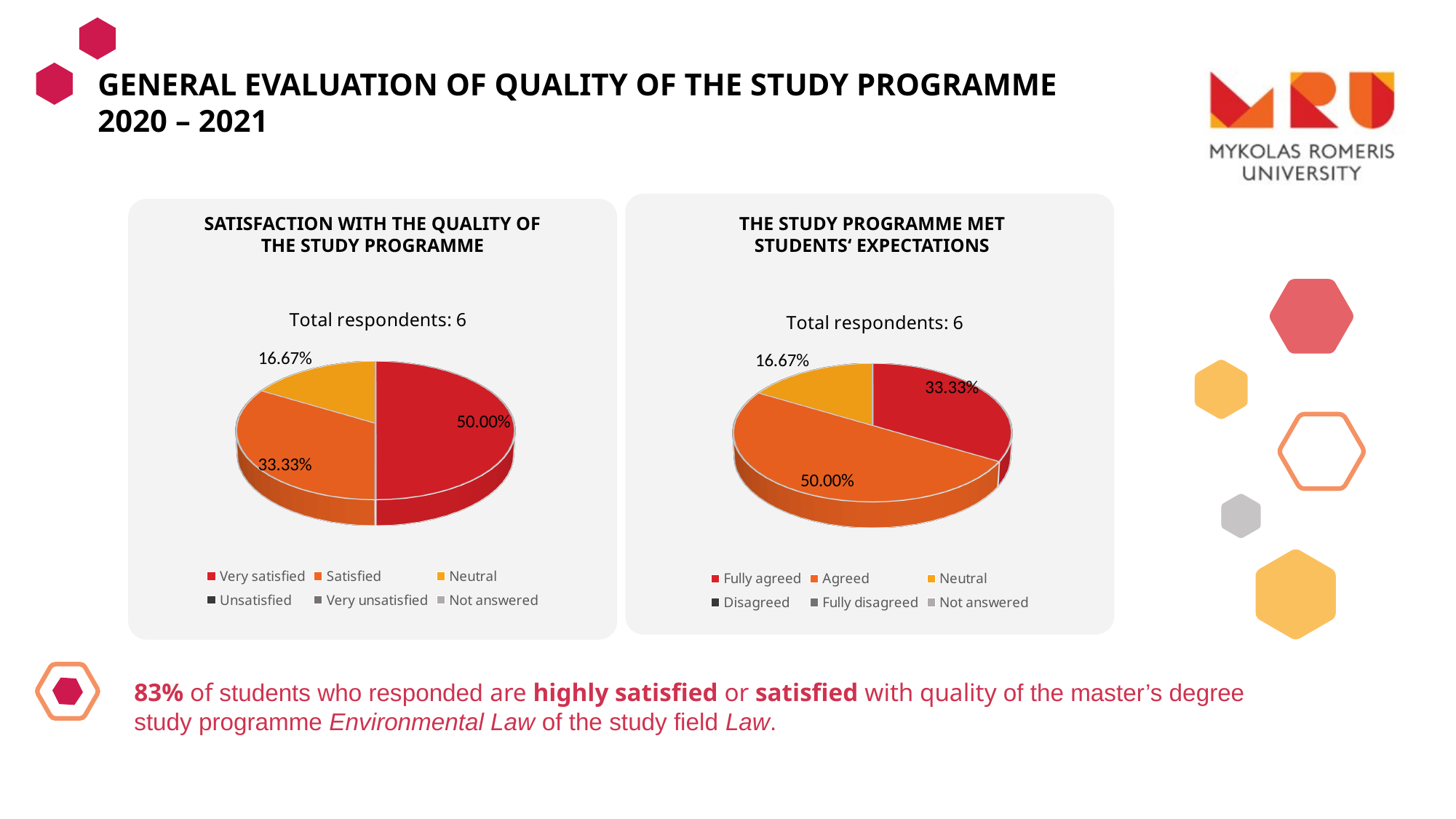
In the 'The study programme met students' expectations' chart, what share of respondents Agreed? 50.00% In the 'The study programme met students' expectations' chart, which is larger: Fully agreed or Neutral? Fully agreed How many entries does the legend of the 'The study programme met students' expectations' chart list? 6 In the 'Satisfaction with the quality of the study programme' chart, what share of respondents were Very satisfied? 50.00% In the 'The study programme met students' expectations' chart, what share of respondents Fully agreed? 33.33% In the 'Satisfaction with the quality of the study programme' chart, which category has the largest slice? Very satisfied What type of chart is used in the 'Satisfaction with the quality of the study programme' panel? Pie chart In the 'Satisfaction with the quality of the study programme' chart, what is the difference between the Very satisfied and Satisfied shares? 16.67% In the 'The study programme met students' expectations' chart, which category has the smallest non-zero slice? Neutral In the 'Satisfaction with the quality of the study programme' chart, what share of respondents were Neutral? 16.67% In the 'The study programme met students' expectations' chart, which category has the largest slice? Agreed In the 'Satisfaction with the quality of the study programme' chart, what share of respondents were Satisfied? 33.33%